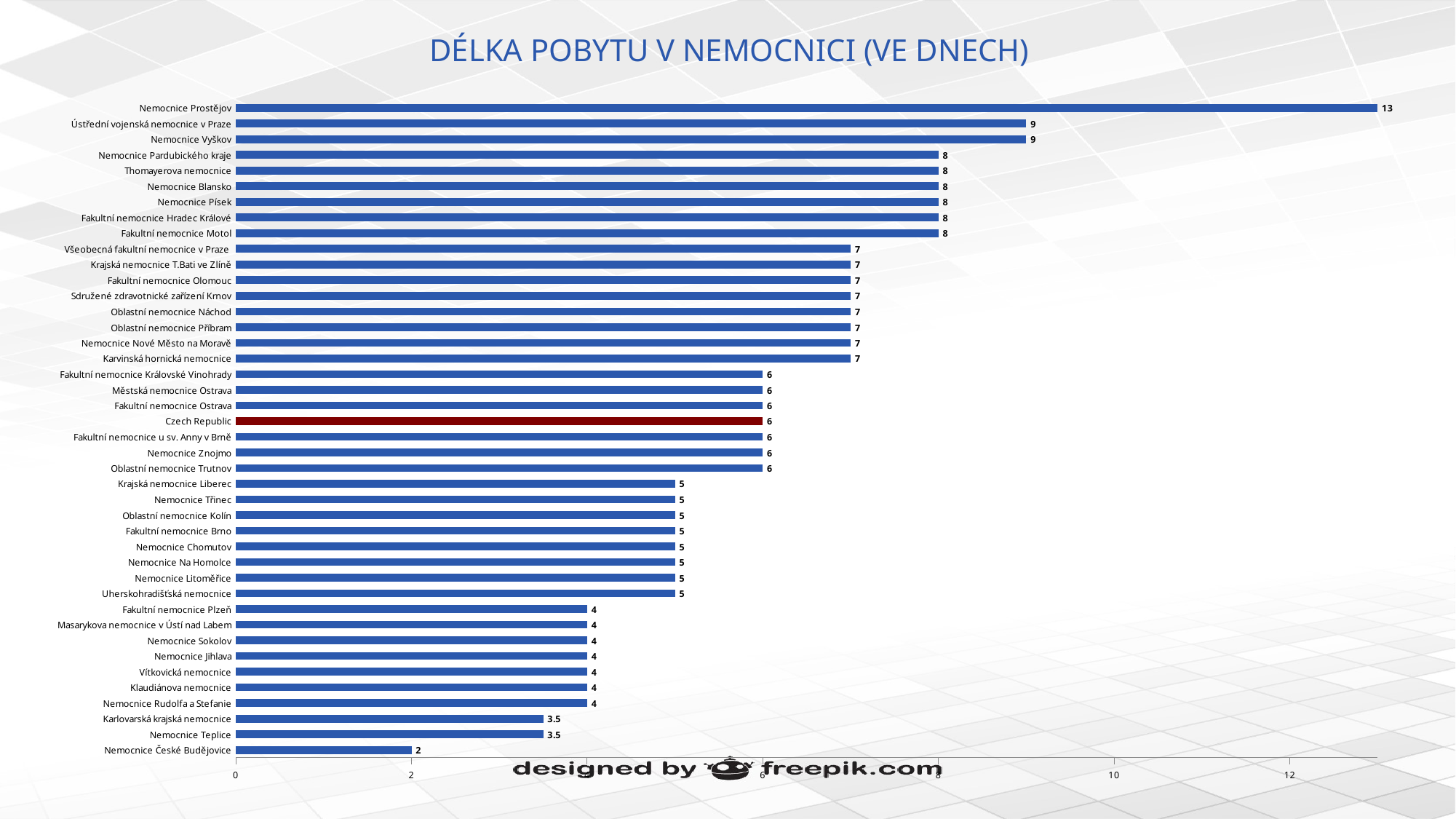
How many hospitals/categories are shown in the chart? 42 What type of chart is shown on the slide? Bar chart Which hospital has the highest length of stay? Nemocnice Prostějov What is the value for Czech Republic? 6 What is the difference between Nemocnice Prostějov and Nemocnice České Budějovice? 11 Which bar is highlighted in a different colour (dark red) from the others? Czech Republic Which is larger, the value for Nemocnice Vyškov or the value for Fakultní nemocnice Plzeň? Nemocnice Vyškov What is the length of hospital stay for Nemocnice Prostějov? 13 What is the value for Karlovarská krajská nemocnice? 3.5 What is the value for Fakultní nemocnice Motol? 8 Is the value for Nemocnice Prostějov greater or less than 12? greater Which hospital has the lowest length of stay? Nemocnice České Budějovice